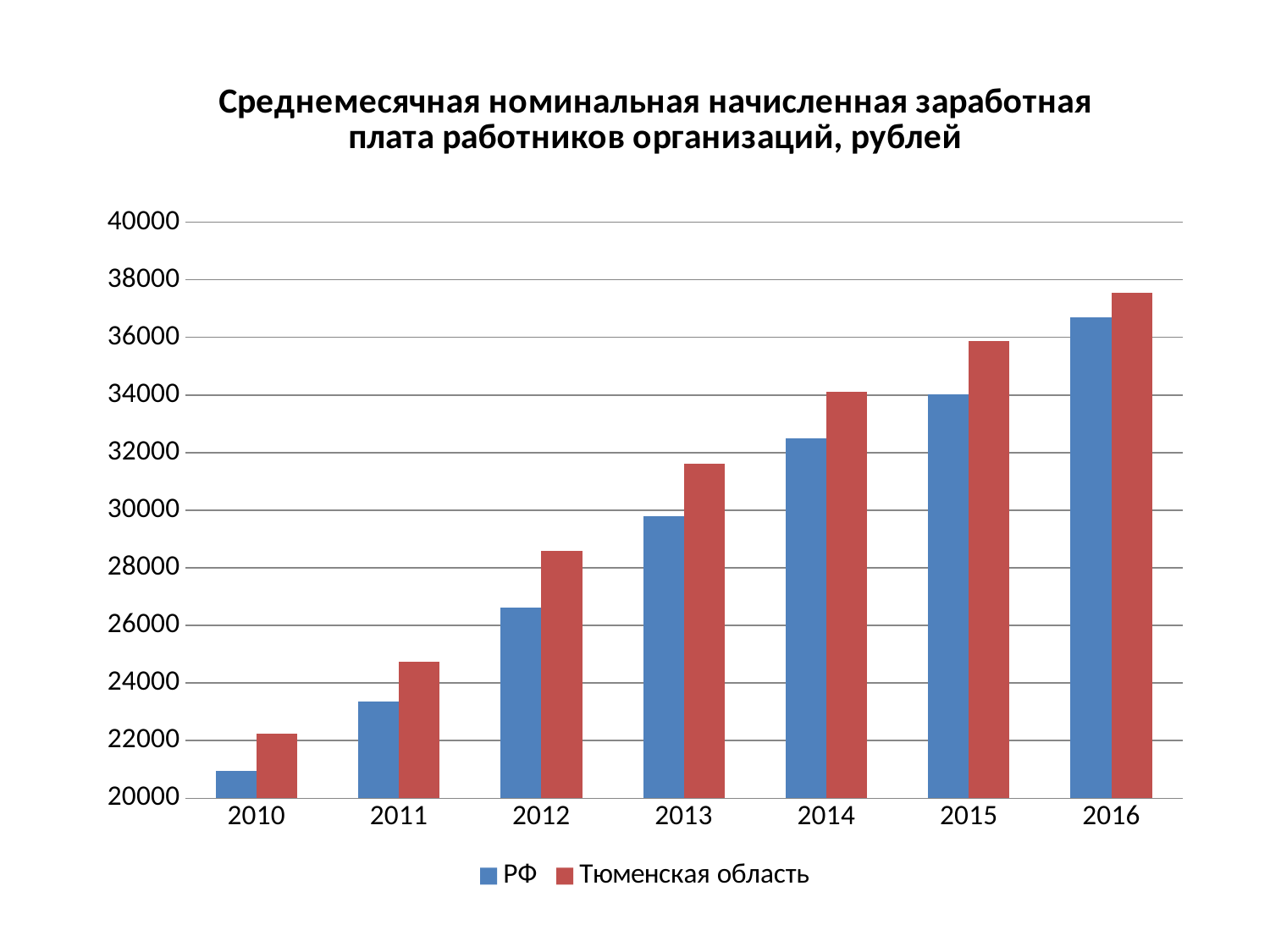
Which is larger in 2014: the value for РФ or the value for Тюменская область? Тюменская область Is the value for РФ in 2012 greater or less than 26000? greater Which year has the highest value for Тюменская область? 2016 How many years are shown on the x axis? 7 Which year has the lowest value for РФ? 2010 Is the value for РФ in 2010 greater or less than 22000? less Is the value for Тюменская область in 2016 greater or less than 38000? less Do the values for РФ rise or fall from 2010 to 2016? rise What kind of chart is shown on the slide? bar chart How many series does the legend list? 2 Which colour represents Тюменская область in the chart? red